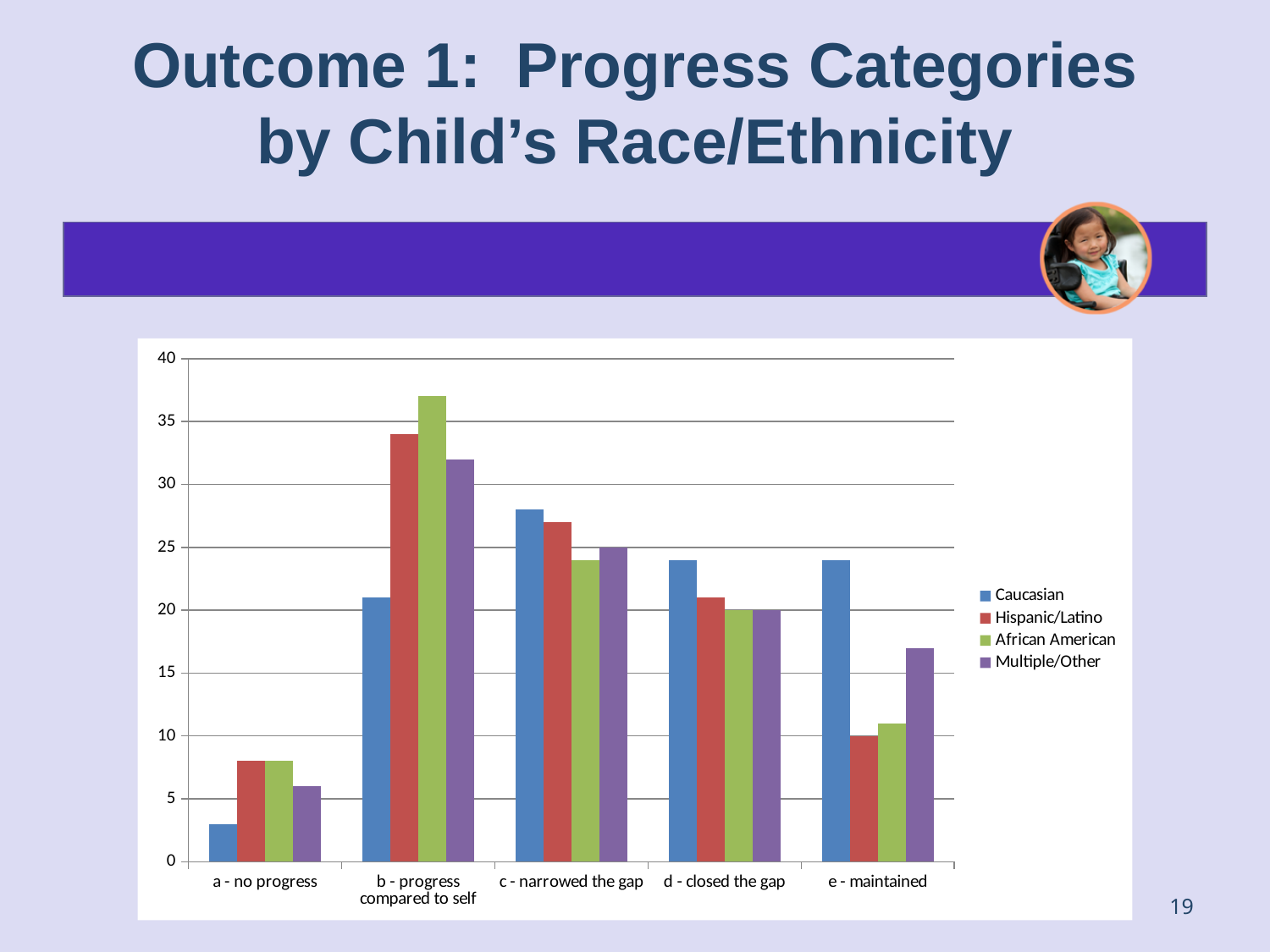
In the 'e - maintained' category, which is larger: the Caucasian value or the Hispanic/Latino value? Caucasian How many progress categories are shown on the x axis? 5 Is the African American value for 'b - progress compared to self' greater or less than 35? greater In which progress category is the African American bar the highest? b - progress compared to self Is the Multiple/Other value for 'e - maintained' greater or less than 15? greater Is the Caucasian value for 'a - no progress' greater or less than 5? less Which series has the lowest bar in the 'a - no progress' category? Caucasian In the 'b - progress compared to self' category, which is larger: the African American value or the Caucasian value? African American What kind of chart is shown on the slide? bar chart What colour represents the Multiple/Other series in the legend? purple How many series does the legend list? 4